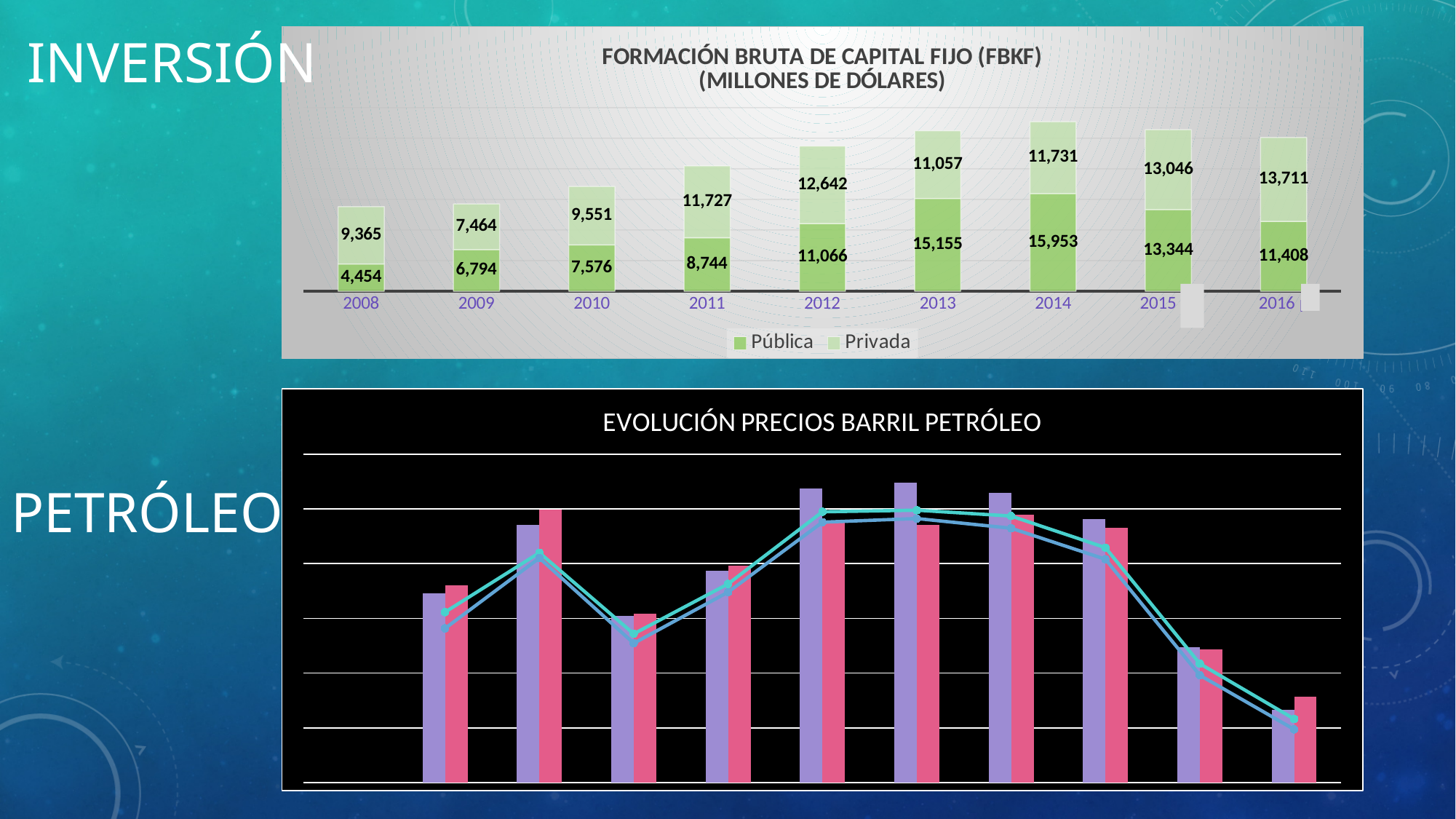
In the FBKF chart, what is the Pública value for 2014? 15,953 In the FBKF chart, which is larger in 2016, Pública or Privada? Privada In the FBKF chart, what is the total of the stacked bar for 2008? 13,819 What kind of chart is the FBKF chart at the top of the slide? stacked bar chart In the FBKF chart, what is the difference between the Pública and Privada values in 2014? 4,222 In the FBKF chart, which year has the lowest Privada value? 2009 What is the title of the chart at the bottom of the slide? EVOLUCIÓN PRECIOS BARRIL PETRÓLEO In the FBKF chart, how many years are shown on the x axis? 9 In the FBKF chart, what is the Privada value for 2011? 11,727 In the FBKF chart, does the Pública value rise or fall from 2008 to 2014? rise In the FBKF chart, which year has the highest Pública value? 2014 In the FBKF chart, how many series does the legend list? 2